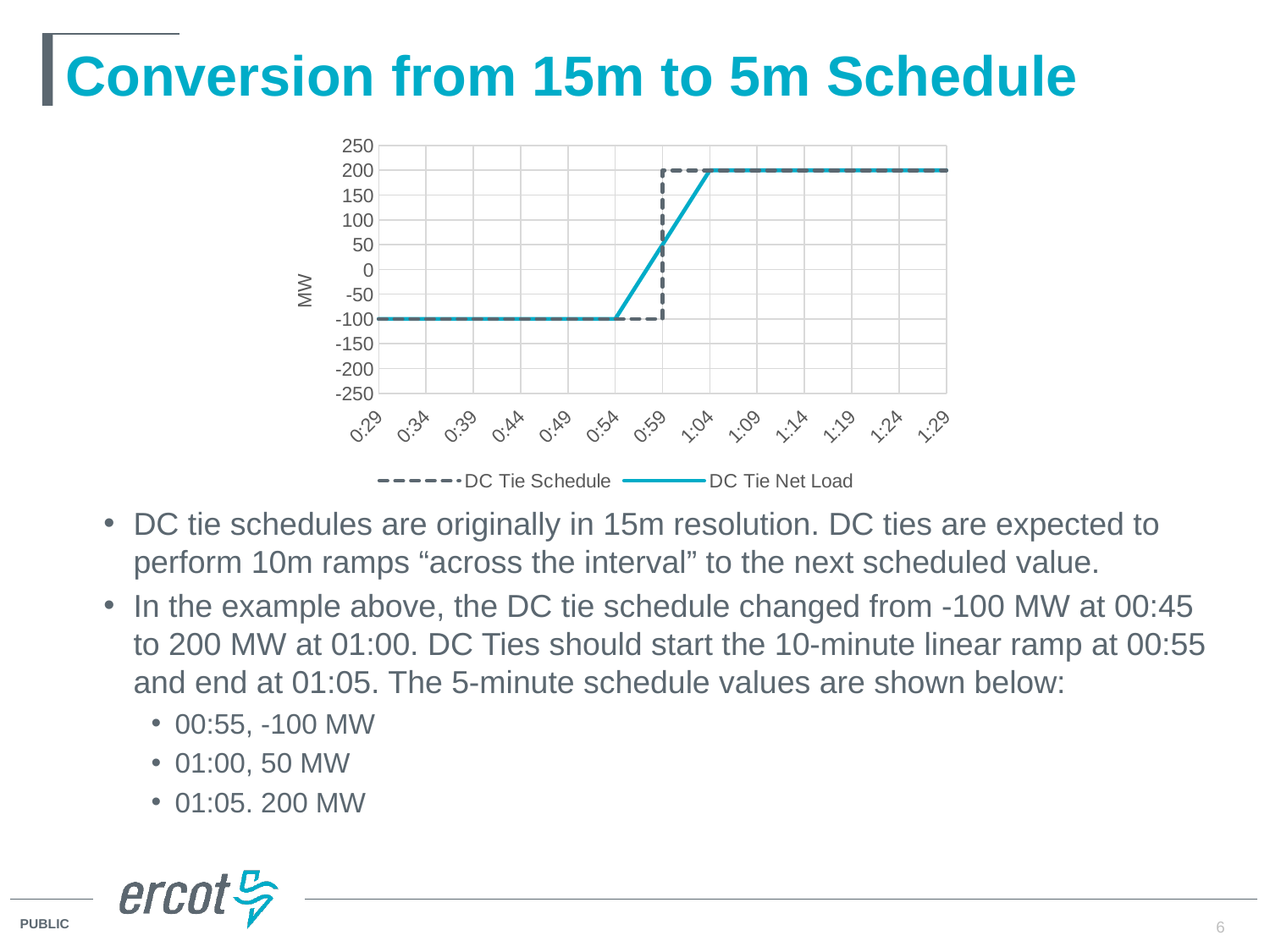
What is the highest value reached by the DC Tie Net Load series? 200 Do the values of the DC Tie Net Load series rise or fall along the x axis? rise By how much does the DC Tie Schedule series increase from its starting level to its final level? 300 What is the label on the vertical axis of the chart? MW What is the value of the DC Tie Schedule series at 1:29? 200 What is the value of the DC Tie Net Load series at 0:44? -100 How many series does the chart legend list? 2 What are the two series named in the chart legend? DC Tie Schedule and DC Tie Net Load What is the value of the DC Tie Net Load series at 1:14? 200 What is the value of the DC Tie Schedule series at 0:29? -100 What is the lowest value of the DC Tie Schedule series? -100 What kind of chart is shown on the slide? line chart